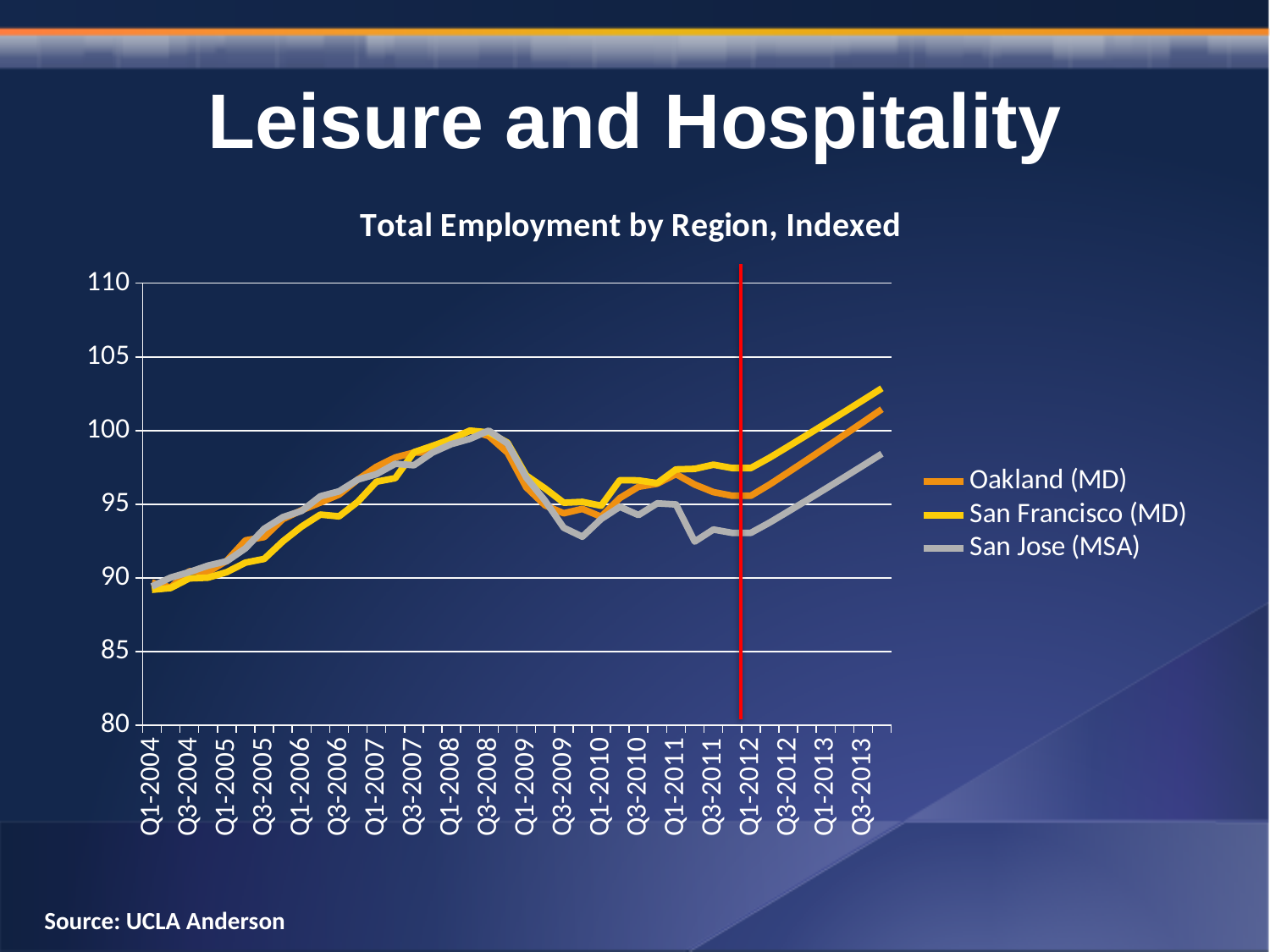
Is the value for San Jose (MSA) at Q1-2012 greater or less than 95? less Which series is drawn in gray? San Jose (MSA) At Q1-2012, which is larger: the value for San Francisco (MD) or the value for San Jose (MSA)? San Francisco (MD) Is the value for San Francisco (MD) at the last point of the series greater or less than 100? greater What is the title of the chart? Total Employment by Region, Indexed How many series does the legend list? 3 Is the value for San Francisco (MD) at Q1-2012 greater or less than 95? greater Which series has the lowest value at the end of the chart? San Jose (MSA) What kind of chart is shown on the slide? Line chart Which series has the highest value at the end of the chart? San Francisco (MD) Do the values for all three series rise or fall from Q1-2012 to the end of the chart? Rise